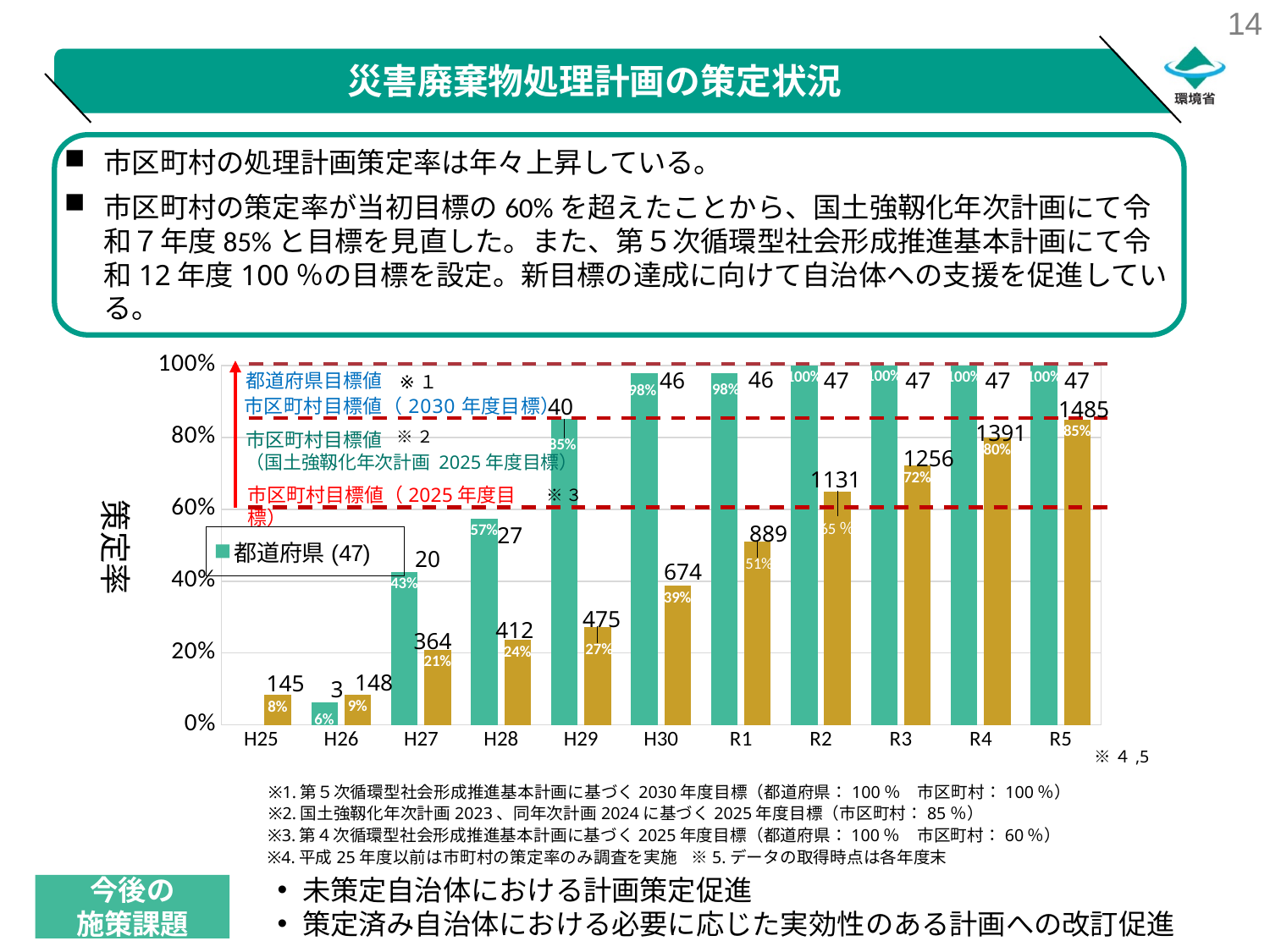
In H28, which is larger: the 策定率 for 都道府県 or for 市区町村? 都道府県 What is the 策定率 for 市区町村 in R5? 85% How many fiscal years are shown on the x axis? 11 What kind of chart is shown on the slide? Bar chart In which year is the 市区町村 策定率 lowest? H25 By how much did the number of 市区町村 increase from R4 to R5? 94 What is the number of 市区町村 shown for H30? 674 Does the 市区町村 策定率 rise or fall from H25 to R5? Rise Is the 市区町村 策定率 for R1 greater or less than 40%? greater What is the 策定率 for 都道府県 in H26? 6% How many 都道府県 had formulated a plan in H29, according to the data label? 40 In which year is the 市区町村 策定率 highest? R5